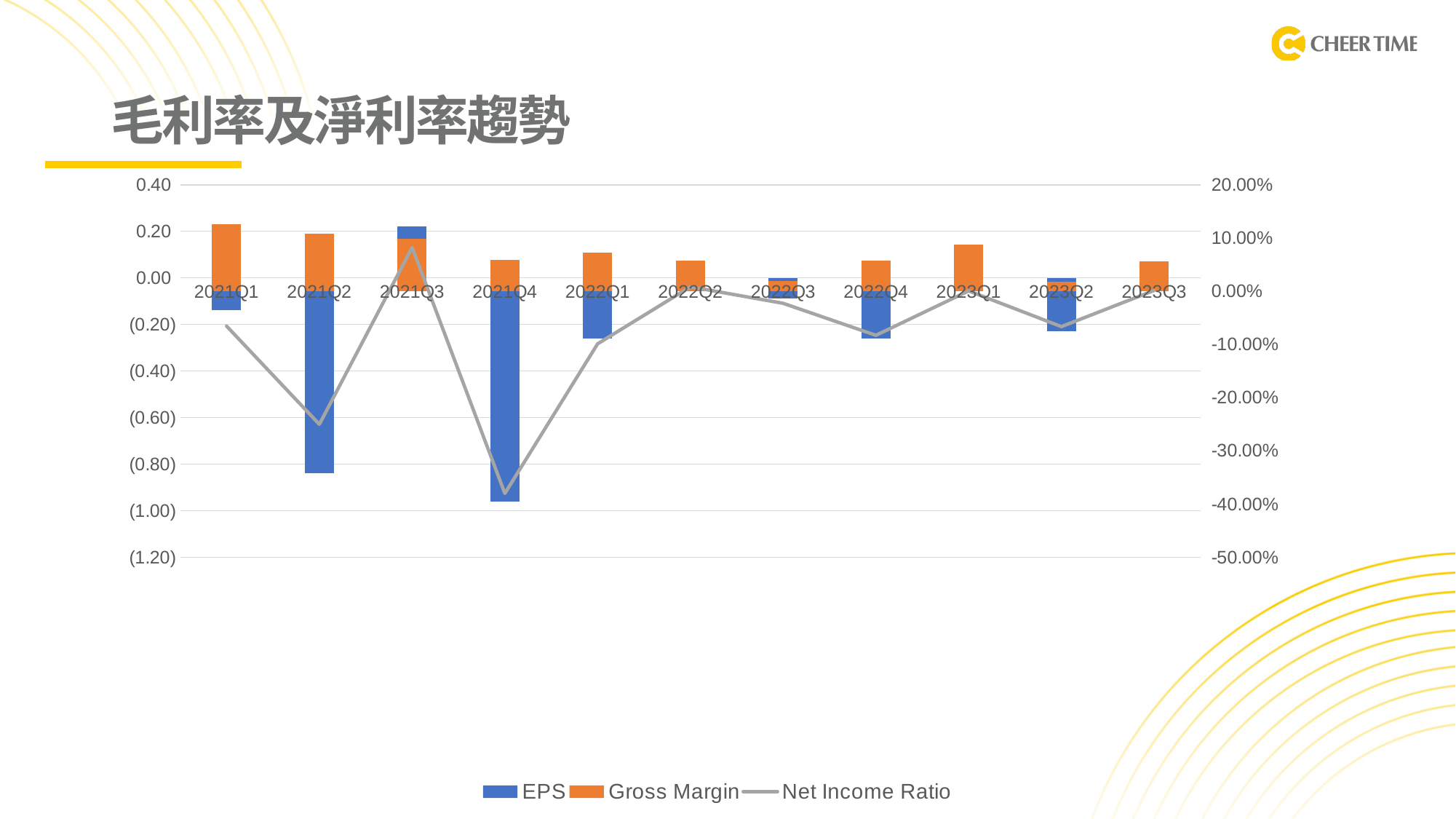
What colour are the EPS bars in the chart? Blue Which series is drawn as a line in the chart? Net Income Ratio How many series does the chart legend list? 3 Is the Net Income Ratio for 2021Q4 greater or less than -30.00%? less What kind of chart is shown on the slide? A combined bar and line chart Which quarter has the highest EPS? 2021Q3 Does the Net Income Ratio rise or fall from 2021Q4 to 2022Q2? rise Which quarter has the highest Gross Margin bar? 2021Q1 Is the EPS value for 2021Q4 greater or less than (0.80)? less Which quarter has the lowest Net Income Ratio? 2021Q4 Which quarter has the lowest EPS? 2021Q4 How many quarters are shown on the x axis of the chart? 11